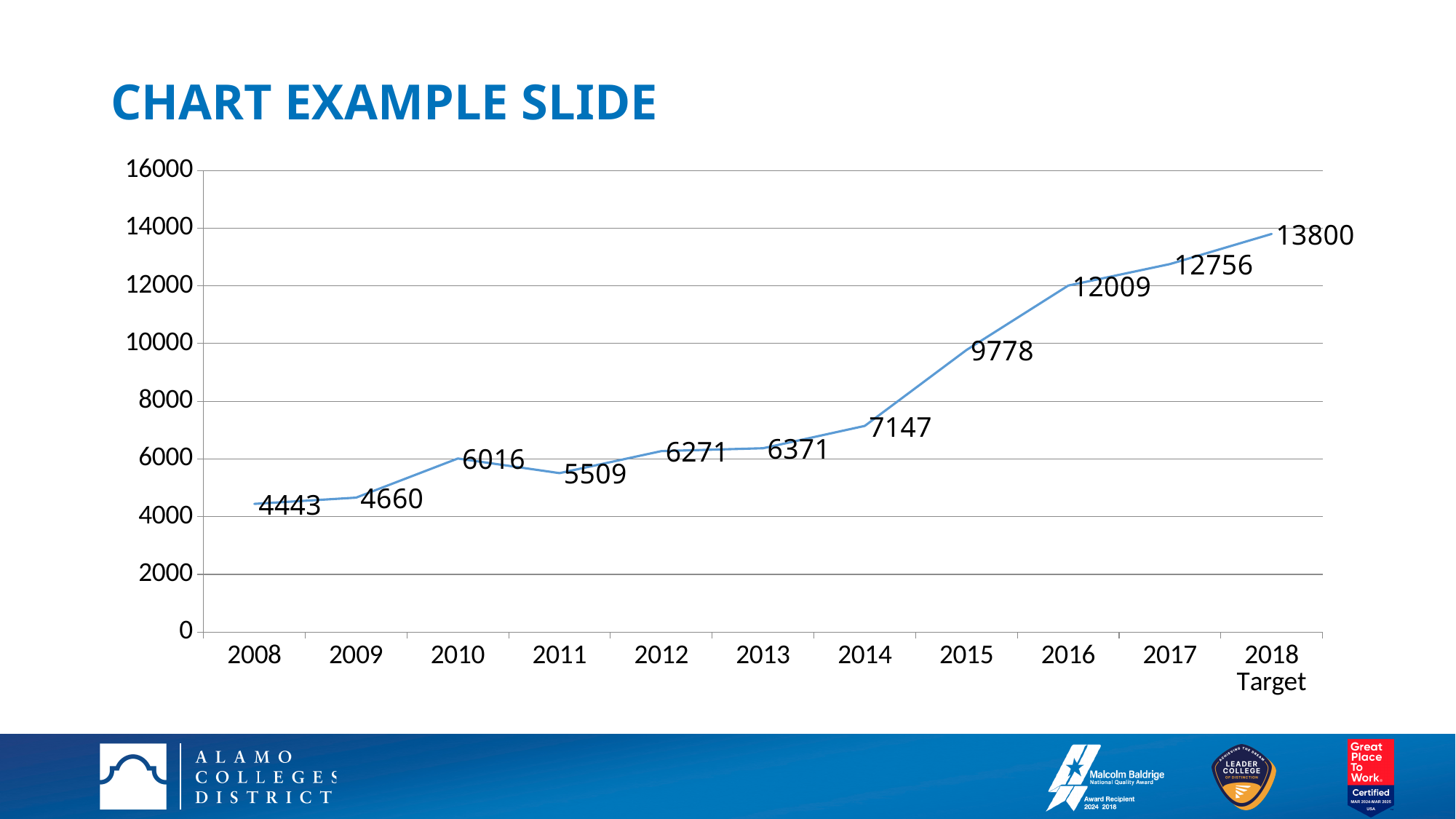
What is the difference between the values for 2016 and 2015? 2231 What is the title of the slide? CHART EXAMPLE SLIDE What is the value for 2015? 9778 Do the values generally rise or fall from 2008 to the 2018 Target? rise Which is larger, the value for 2010 or the value for 2011? 2010 What is the value for 2008? 4443 What is the value for the 2018 Target? 13800 How many points are plotted on the line? 11 Which point on the chart has the highest value? 2018 Target Which year has the lowest value? 2008 What kind of chart is shown on the slide? line chart Is the value for 2014 greater or less than 8000? less